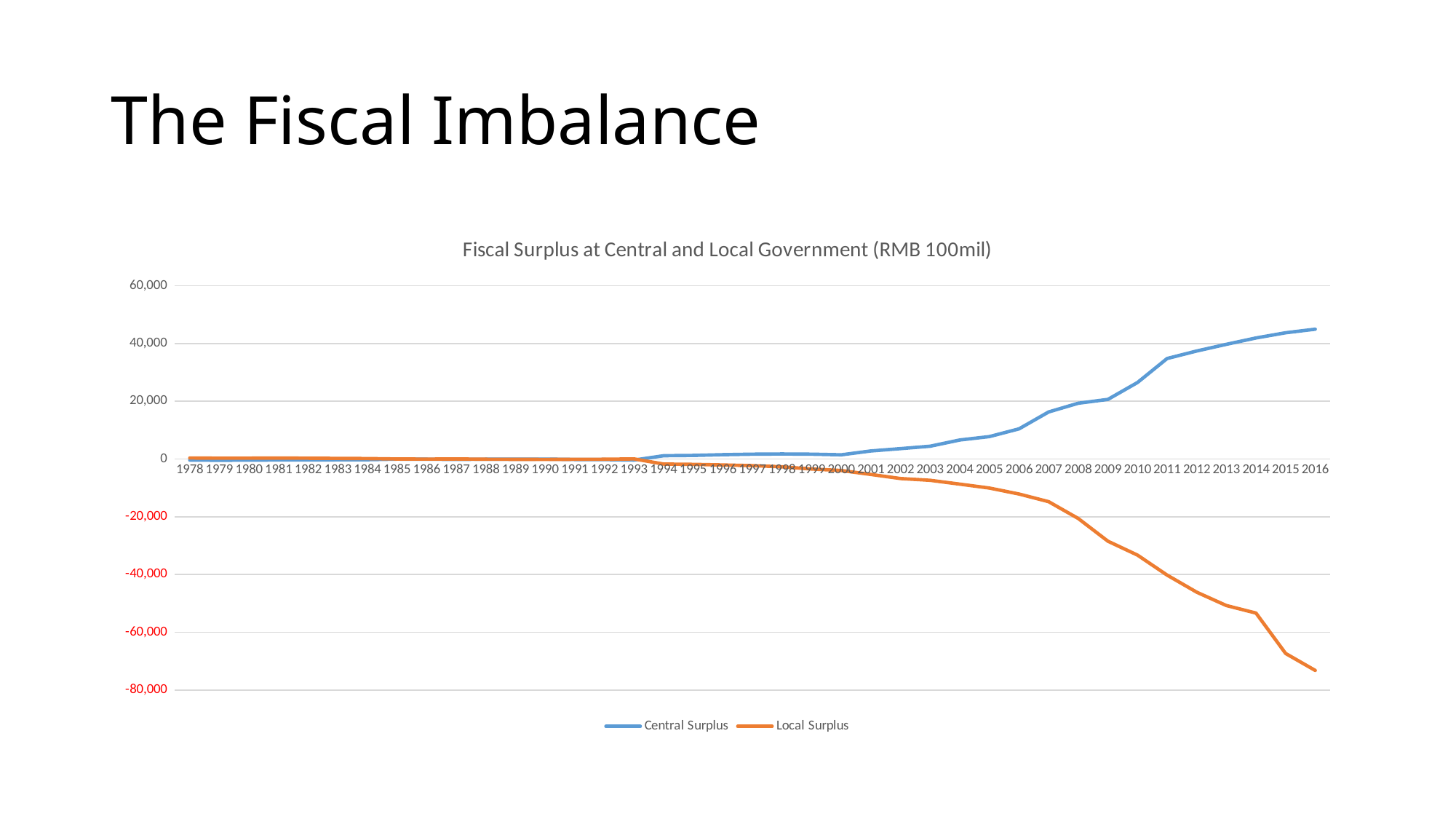
How many years are plotted along the x axis? 39 Does the Local Surplus line rise or fall from 1978 to 2016? fall Is the Local Surplus value for 2016 greater or less than -60,000? less Is the Central Surplus value for 2016 greater or less than 40,000? greater Is the Central Surplus value for 2007 greater or less than 20,000? less What are the two series named in the legend? Central Surplus and Local Surplus What kind of chart is shown on the slide? line chart Does the Central Surplus line rise or fall from 1978 to 2016? rise In 2016, which series has the larger value, Central Surplus or Local Surplus? Central Surplus How many series does the legend list? 2 What is the title of the chart? Fiscal Surplus at Central and Local Government (RMB 100mil)